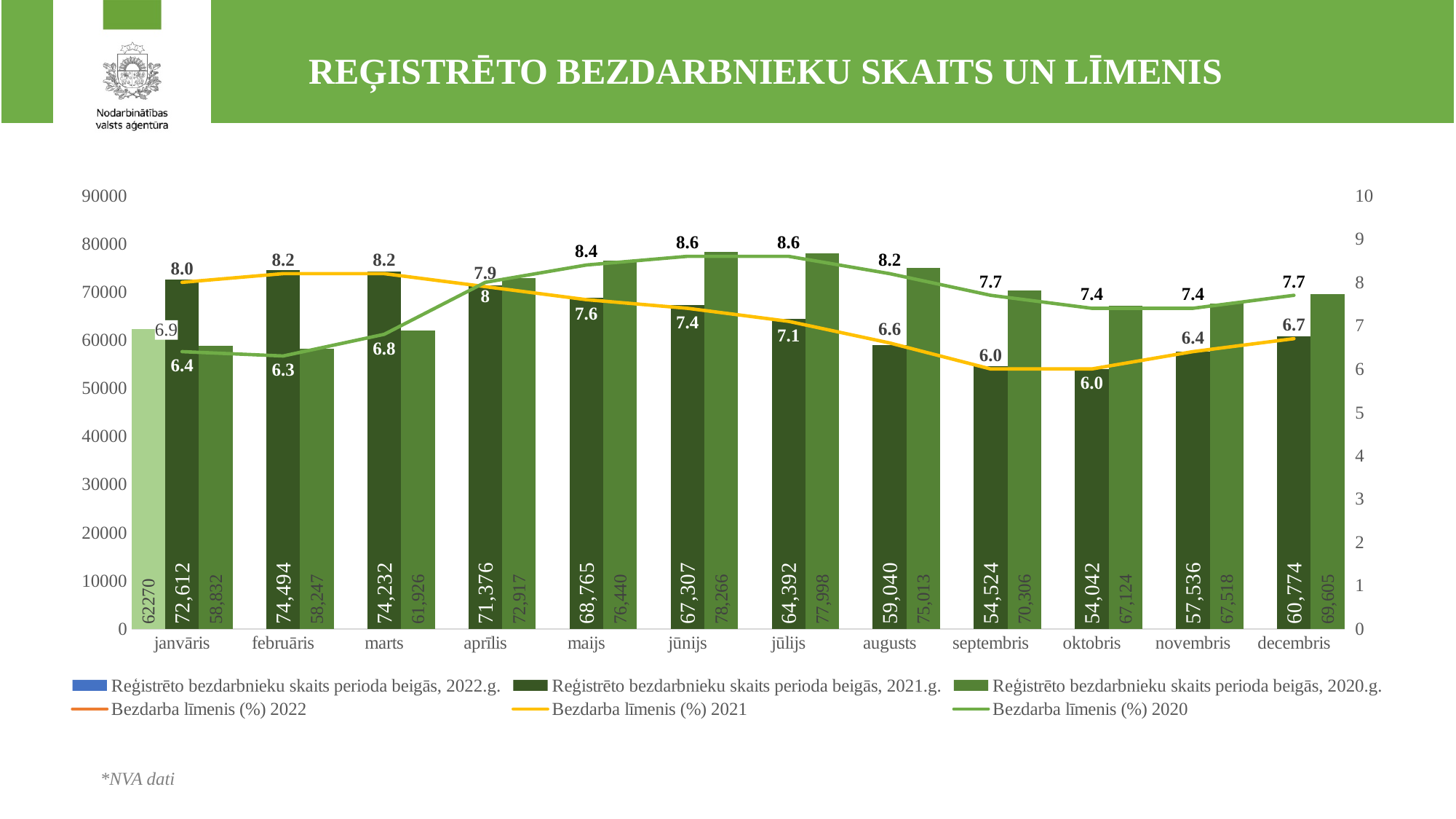
What is the unemployment rate (%) for 2020 in maijs? 8.4 Which is larger in marts: the registered unemployed count for 2021 or for 2020? 2021 What is the registered unemployed count at the end of the period for 2021 in janvāris? 72,612 Does the unemployment rate (%) for 2021 rise or fall from janvāris to oktobris? fall How many months are shown on the x axis? 12 How many series does the legend list? 6 What is the registered unemployed count for 2022 in janvāris? 62270 What is the registered unemployed count at the end of the period for 2020 in jūnijs? 78,266 In which month is the registered unemployed count for 2021 the lowest? oktobris What is the difference between the 2020 and 2021 registered unemployed counts in decembris? 8,831 In which month is the registered unemployed count for 2020 the highest? jūnijs What is the unemployment rate (%) for 2021 in septembris? 6.0